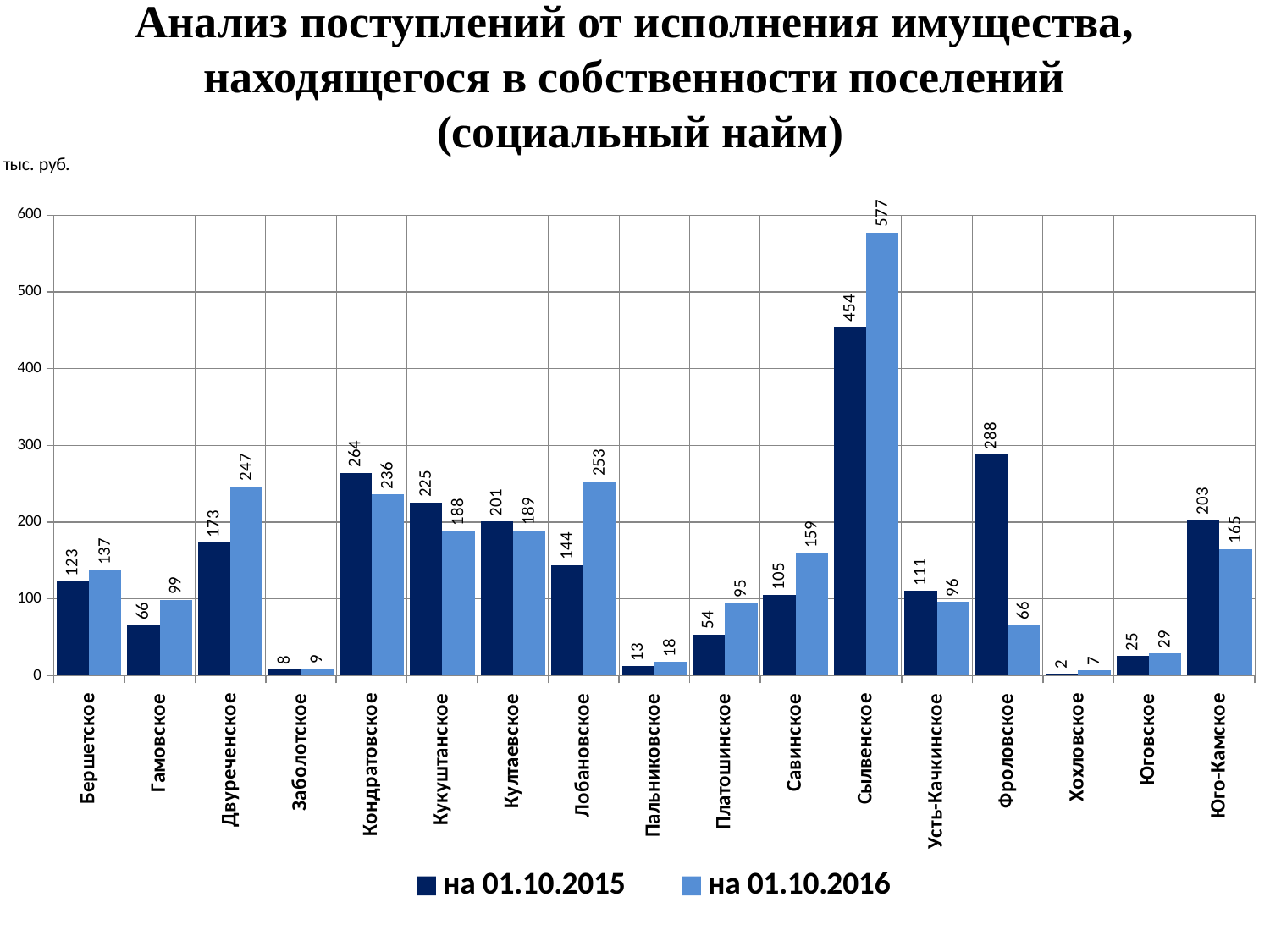
How many categories are shown on the x axis? 17 Is the value for Кондратовское in the series на 01.10.2015 greater or less than 200? greater What is the value for Лобановское in the series на 01.10.2016? 253 For Фроловское, which series has the larger value: на 01.10.2015 or на 01.10.2016? на 01.10.2015 What is the difference between the на 01.10.2016 and на 01.10.2015 values for Двуреченское? 74 What kind of chart is shown on the slide? bar chart Which category has the lowest value in the series на 01.10.2016? Хохловское How many series does the legend list? 2 What is the value for Фроловское in the series на 01.10.2015? 288 What is the value for Сылвенское in the series на 01.10.2016? 577 Which category has the highest value in the series на 01.10.2015? Сылвенское What unit is indicated above the vertical axis? тыс. руб.